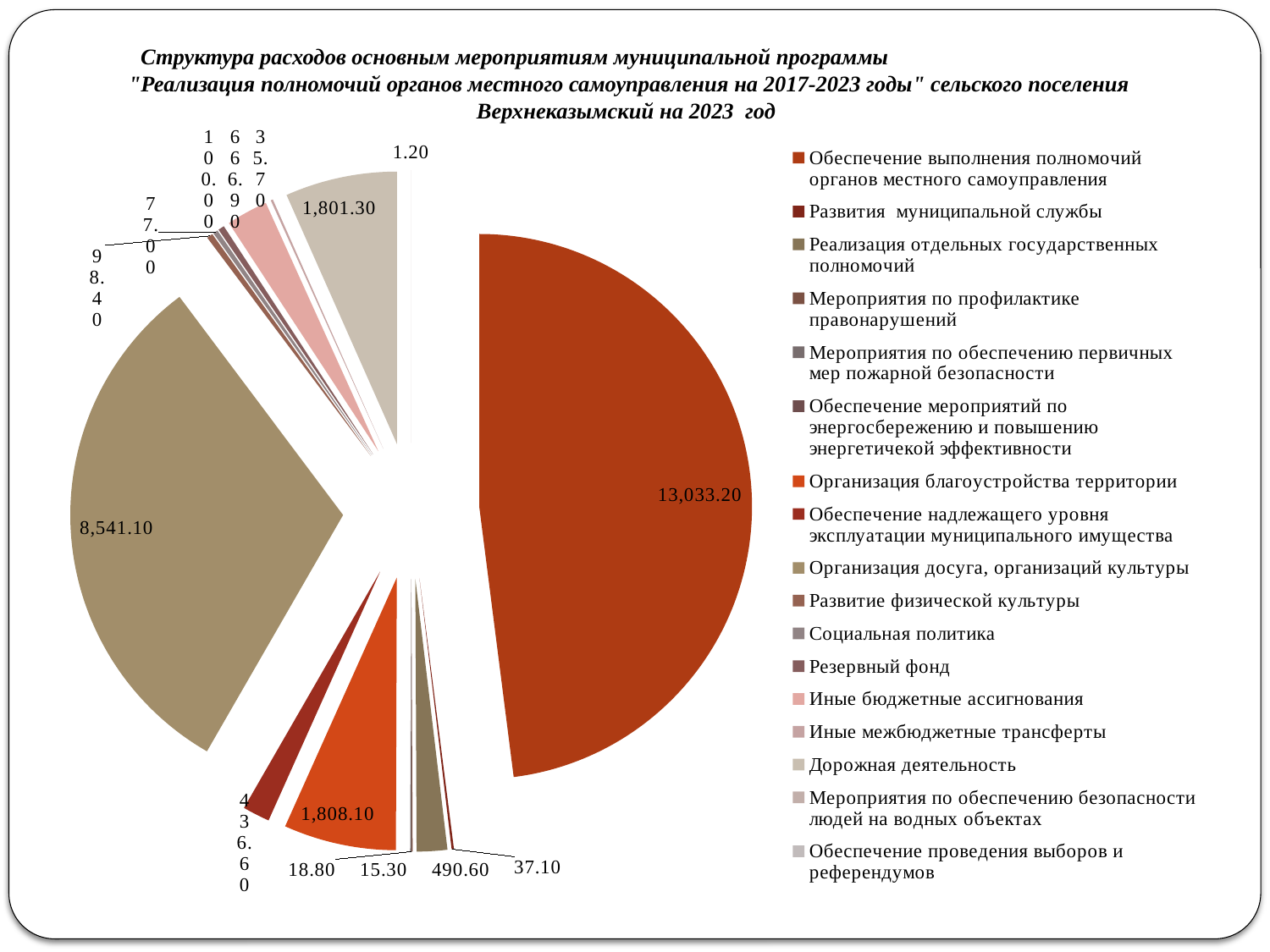
What kind of chart is shown on the slide? pie chart Which is larger: the value for Организация благоустройства территории or the value for Дорожная деятельность? Организация благоустройства территории What is the value of the second-largest slice of the pie chart? 8,541.10 For which year does the chart title say the expenditure structure is shown? 2023 What is the difference between the values for Организация благоустройства территории and Дорожная деятельность? 6.80 Which category has the largest slice of the pie chart? Обеспечение выполнения полномочий органов местного самоуправления What is the smallest value labelled on the pie chart? 1.20 What is the value of the largest slice of the pie chart? 13,033.20 What is the difference between the largest slice (13,033.20) and the second-largest slice (8,541.10)? 4,492.10 What is the value shown for Организация благоустройства территории? 1,808.10 What is the value shown for Дорожная деятельность? 1,801.30 How many categories does the legend of the pie chart list? 17